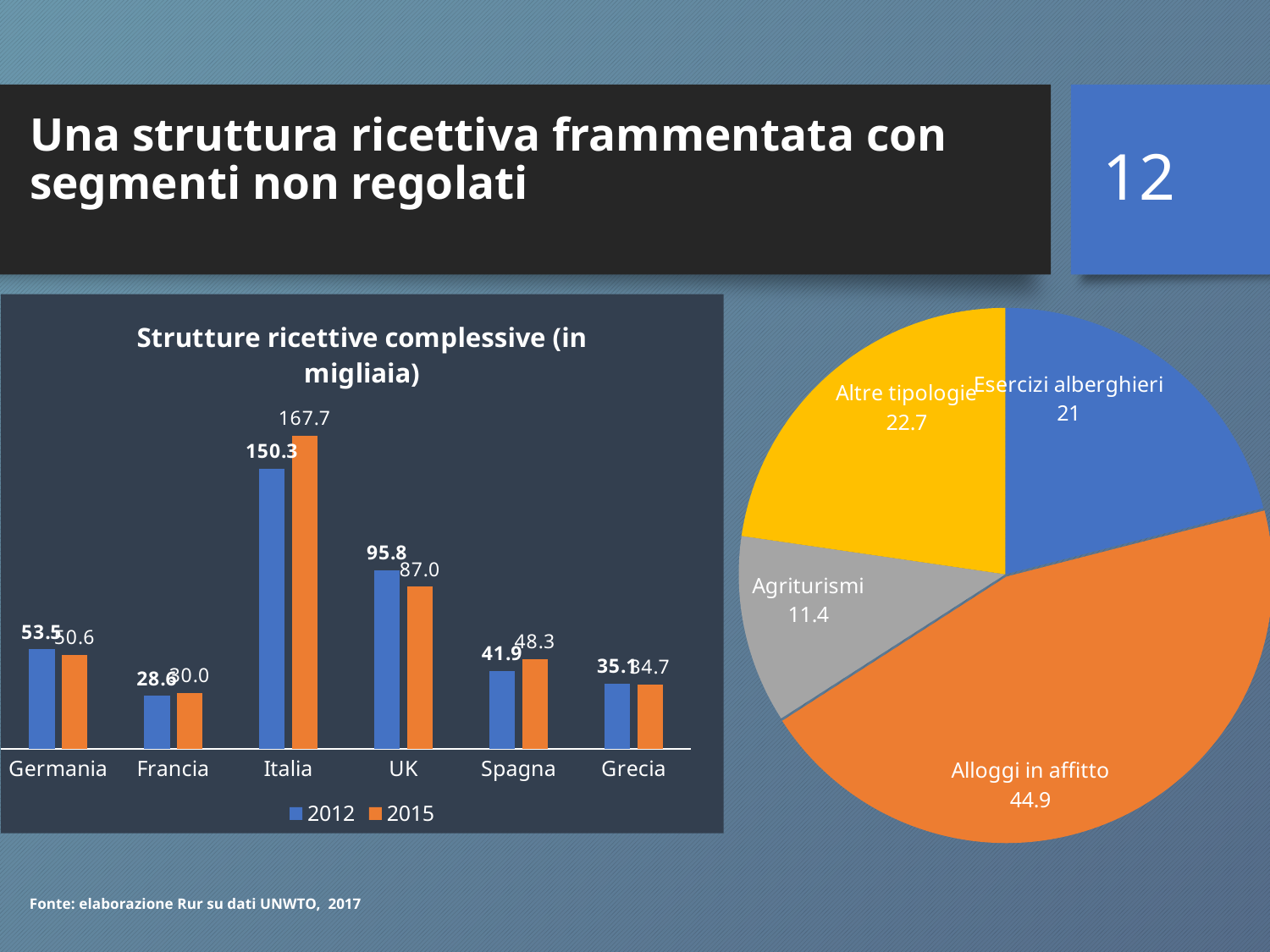
What kind of chart is shown on the right side of the slide? pie chart In the 'Strutture ricettive complessive' bar chart, what is the 2015 value for Spagna? 48.3 In the 'Strutture ricettive complessive' bar chart, what is the 2012 value for UK? 95.8 In the 'Strutture ricettive complessive' bar chart, how many series does the legend list? 2 In the 'Strutture ricettive complessive' bar chart, which country has the highest 2015 value? Italia In the pie chart on the right, which category has the largest slice? Alloggi in affitto In the 'Strutture ricettive complessive' bar chart, how many countries are shown on the x axis? 6 In the 'Strutture ricettive complessive' bar chart, is the UK value larger in 2012 or in 2015? 2012 What kind of chart is the 'Strutture ricettive complessive (in migliaia)' chart on the left? bar chart In the 'Strutture ricettive complessive' bar chart, what is the difference between the 2015 and 2012 values for Italia? 17.4 In the pie chart on the right, what is the value for Agriturismi? 11.4 In the 'Strutture ricettive complessive' bar chart, what is the 2015 value for Italia? 167.7